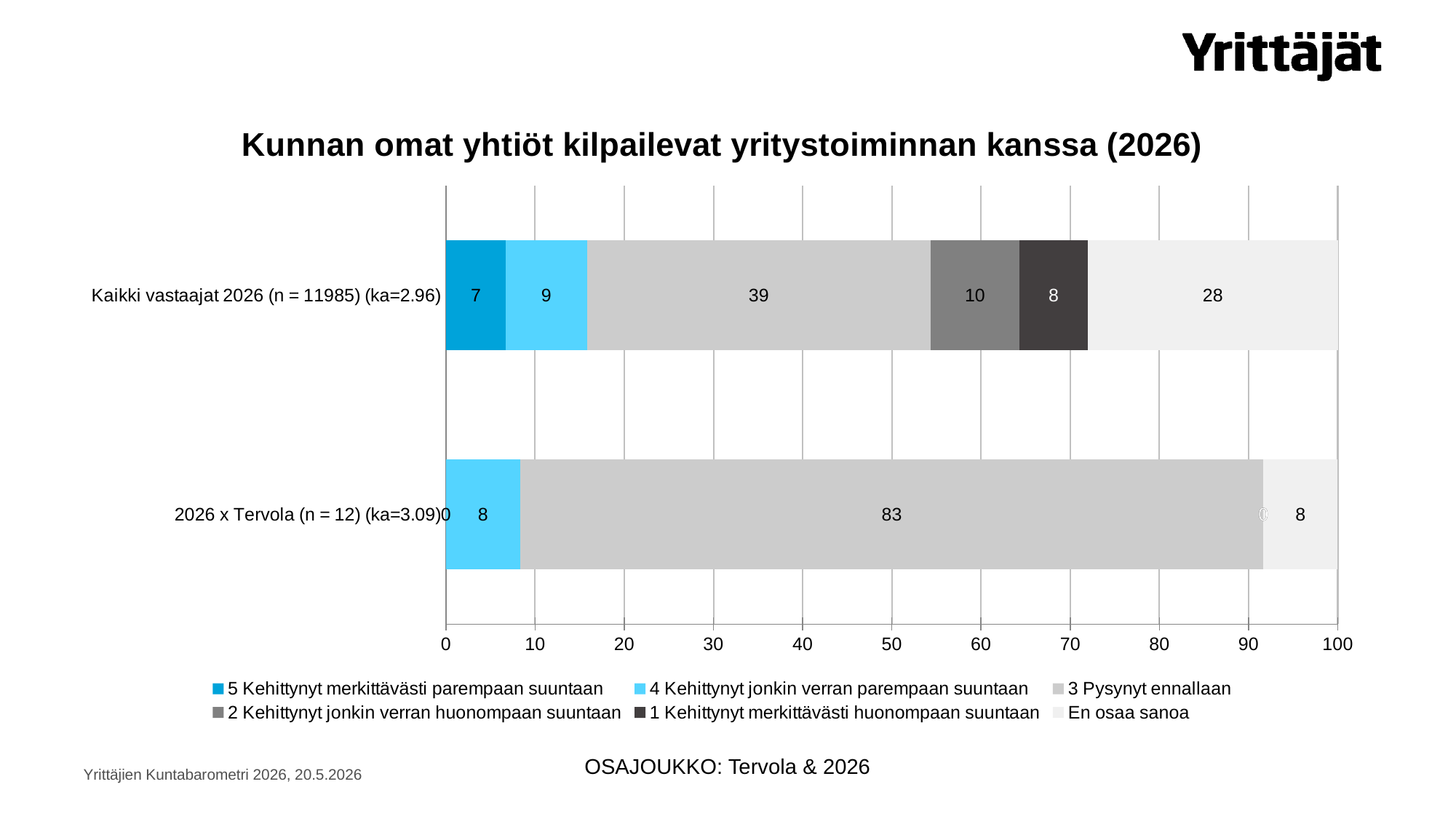
What is the value of '5 Kehittynyt merkittävästi parempaan suuntaan' for 'Kaikki vastaajat 2026 (n = 11985) (ka=2.96)'? 7 What kind of chart is shown on the slide? Stacked bar chart What is the value of '3 Pysynyt ennallaan' for '2026 x Tervola (n = 12) (ka=3.09)'? 83 What is the value of '4 Kehittynyt jonkin verran parempaan suuntaan' for '2026 x Tervola (n = 12) (ka=3.09)'? 8 What is the value of 'En osaa sanoa' for 'Kaikki vastaajat 2026 (n = 11985) (ka=2.96)'? 28 How many series does the legend list? 6 What is the difference between the '3 Pysynyt ennallaan' values for '2026 x Tervola (n = 12) (ka=3.09)' and 'Kaikki vastaajat 2026 (n = 11985) (ka=2.96)'? 44 What is the value of '3 Pysynyt ennallaan' for 'Kaikki vastaajat 2026 (n = 11985) (ka=2.96)'? 39 What is the title of the chart? Kunnan omat yhtiöt kilpailevat yritystoiminnan kanssa (2026) Which category has the larger value for 'En osaa sanoa': 'Kaikki vastaajat 2026 (n = 11985) (ka=2.96)' or '2026 x Tervola (n = 12) (ka=3.09)'? Kaikki vastaajat 2026 (n = 11985) (ka=2.96) How many categories (bars) are plotted in the chart? 2 Which series has the highest value for 'Kaikki vastaajat 2026 (n = 11985) (ka=2.96)'? 3 Pysynyt ennallaan